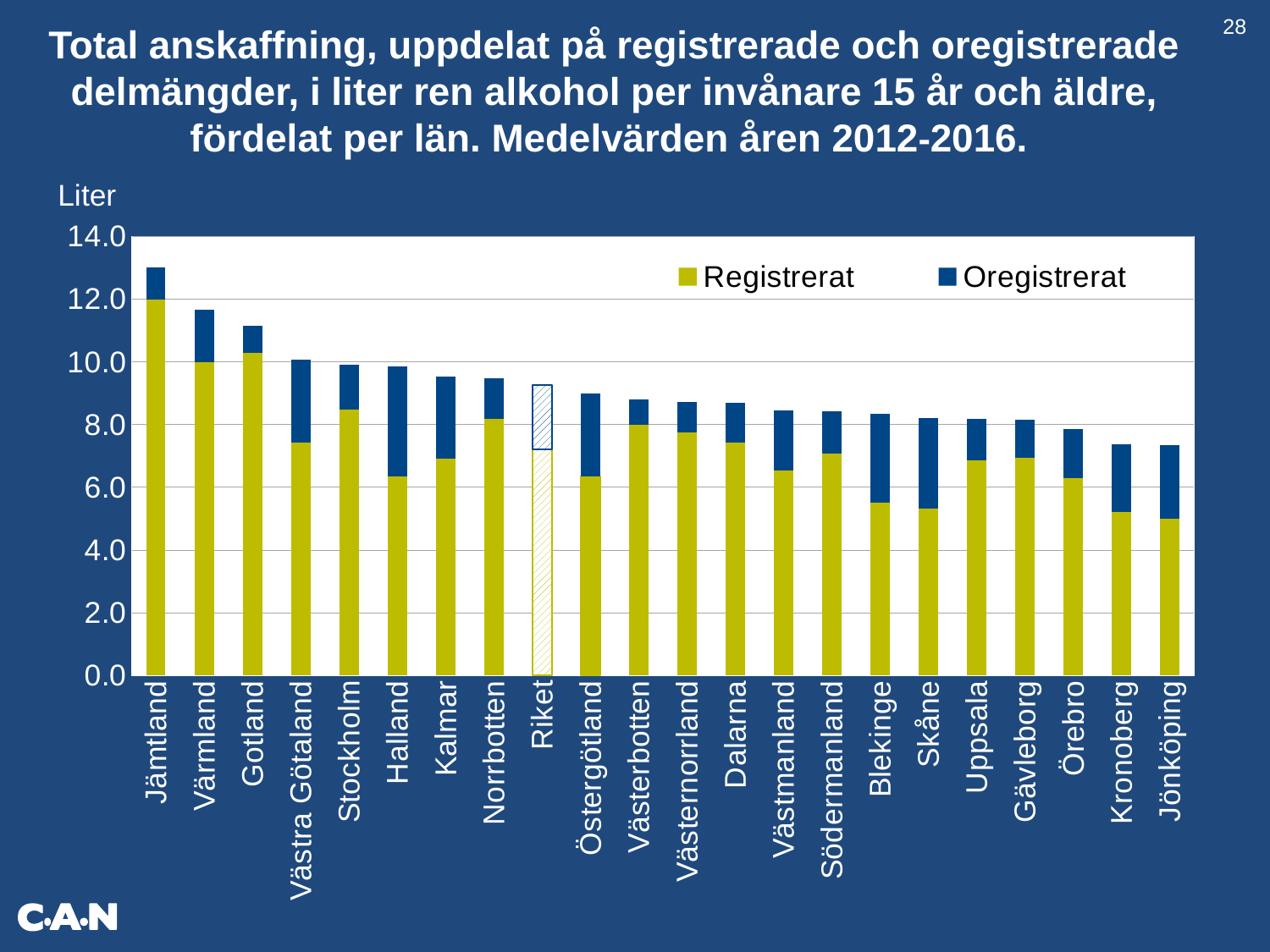
Which has the larger Registrerat value, Stockholm or Halland? Stockholm Which legend entry is shown in dark blue? Oregistrerat Is the Registrerat value for Kronoberg greater or less than 6.0? less Is the total value for Gotland greater or less than 10.0? greater Is the total value for Jönköping greater or less than 8.0? less Do the total bar heights generally rise or fall from left to right along the x axis? Fall What kind of chart is shown on the slide? Stacked bar chart Which category has the highest total bar? Jämtland Which has the larger total bar, Gotland or Skåne? Gotland How many series does the legend list? 2 How many categories (bars) are shown along the x axis? 22